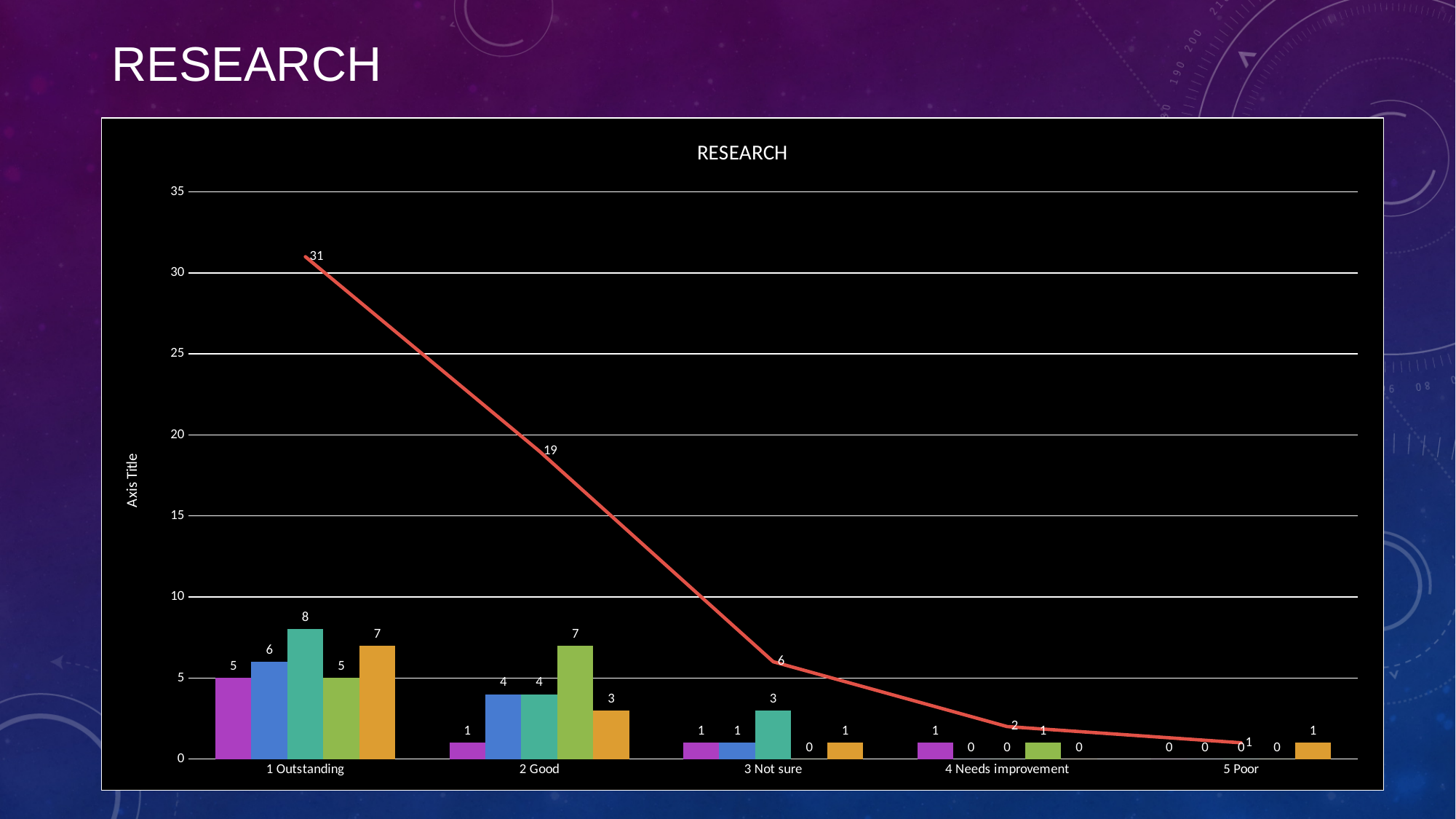
What is the value of the green bar at 2 Good? 7 At which category does the red line reach its highest value? 1 Outstanding What is the title of the chart? RESEARCH Is the red line's value at 2 Good greater or less than the teal bar's value at 2 Good? greater At which category does the red line reach its lowest value? 5 Poor What is the value of the red line at 2 Good? 19 What is the value of the teal bar at 1 Outstanding? 8 How many categories are shown on the x axis? 5 Does the red line rise or fall from 1 Outstanding to 5 Poor? fall What is the value of the red line at 1 Outstanding? 31 What is the value of the red line at 3 Not sure? 6 What is the difference between the red line's values at 1 Outstanding and 2 Good? 12